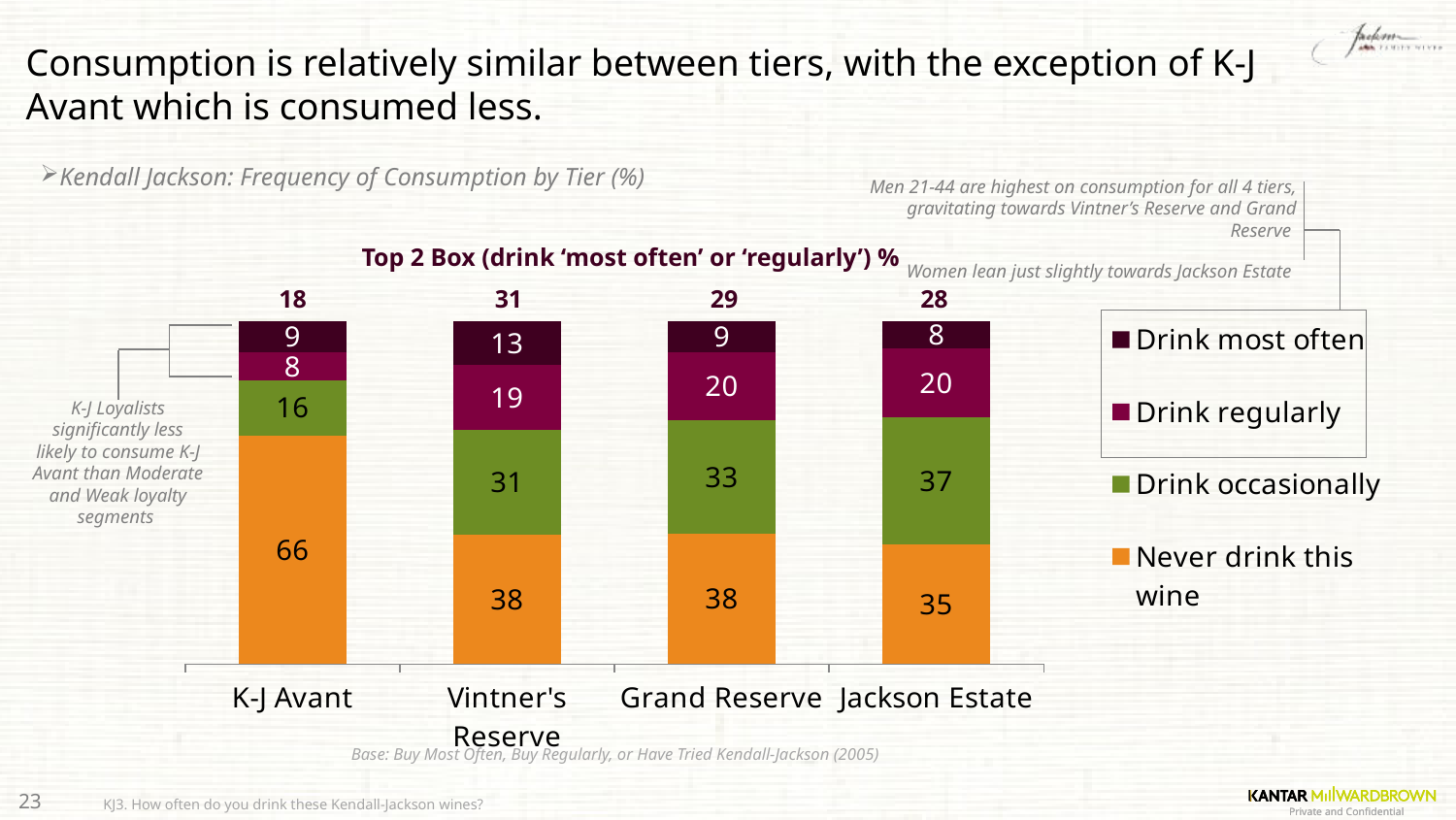
What kind of chart is shown on the slide? Stacked bar chart What is the 'Drink occasionally' value for Jackson Estate? 37 Which tier has the highest 'Never drink this wine' value? K-J Avant Which tier has the lowest Top 2 Box value? K-J Avant How many tiers (categories) are shown on the x axis? 4 What is the difference between the 'Never drink this wine' values for K-J Avant and Jackson Estate? 31 What is the Top 2 Box value shown above the Grand Reserve bar? 29 What is the 'Drink most often' value for Vintner's Reserve? 13 What percentage of respondents never drink K-J Avant? 66 What is the total of the stacked bar for Grand Reserve? 100 Which is larger: the 'Drink occasionally' value for Vintner's Reserve or for Grand Reserve? Grand Reserve How many series does the legend list? 4